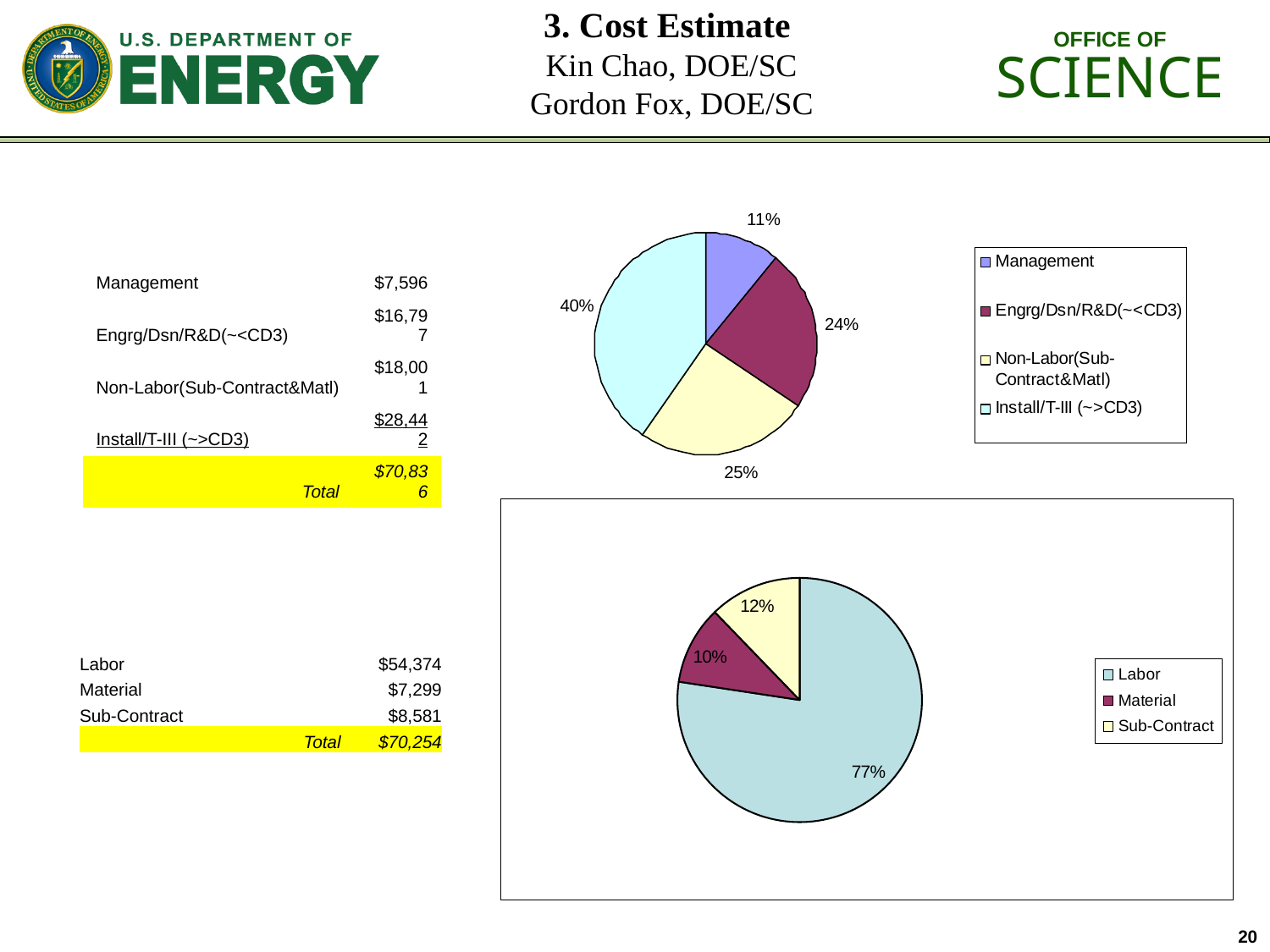
In the top pie chart, which category has the largest share? Install/T-III (~>CD3) In the bottom pie chart, what percentage is shown for Material? 10% In the top pie chart, what percentage is shown for Engrg/Dsn/R&D(~<CD3)? 24% In the bottom pie chart, which category has the smallest share? Material In the top pie chart, what percentage is shown for Management? 11% How many categories does the legend of the top pie chart list? 4 In the bottom pie chart, what percentage is shown for Labor? 77% In the top pie chart, what percentage is shown for Install/T-III (~>CD3)? 40% How many slices does the bottom pie chart have? 3 In the top pie chart, which category has the smallest share? Management In the bottom pie chart, what is the difference in percentage points between Labor and Sub-Contract? 65 What kind of chart is the top chart on the slide? pie chart